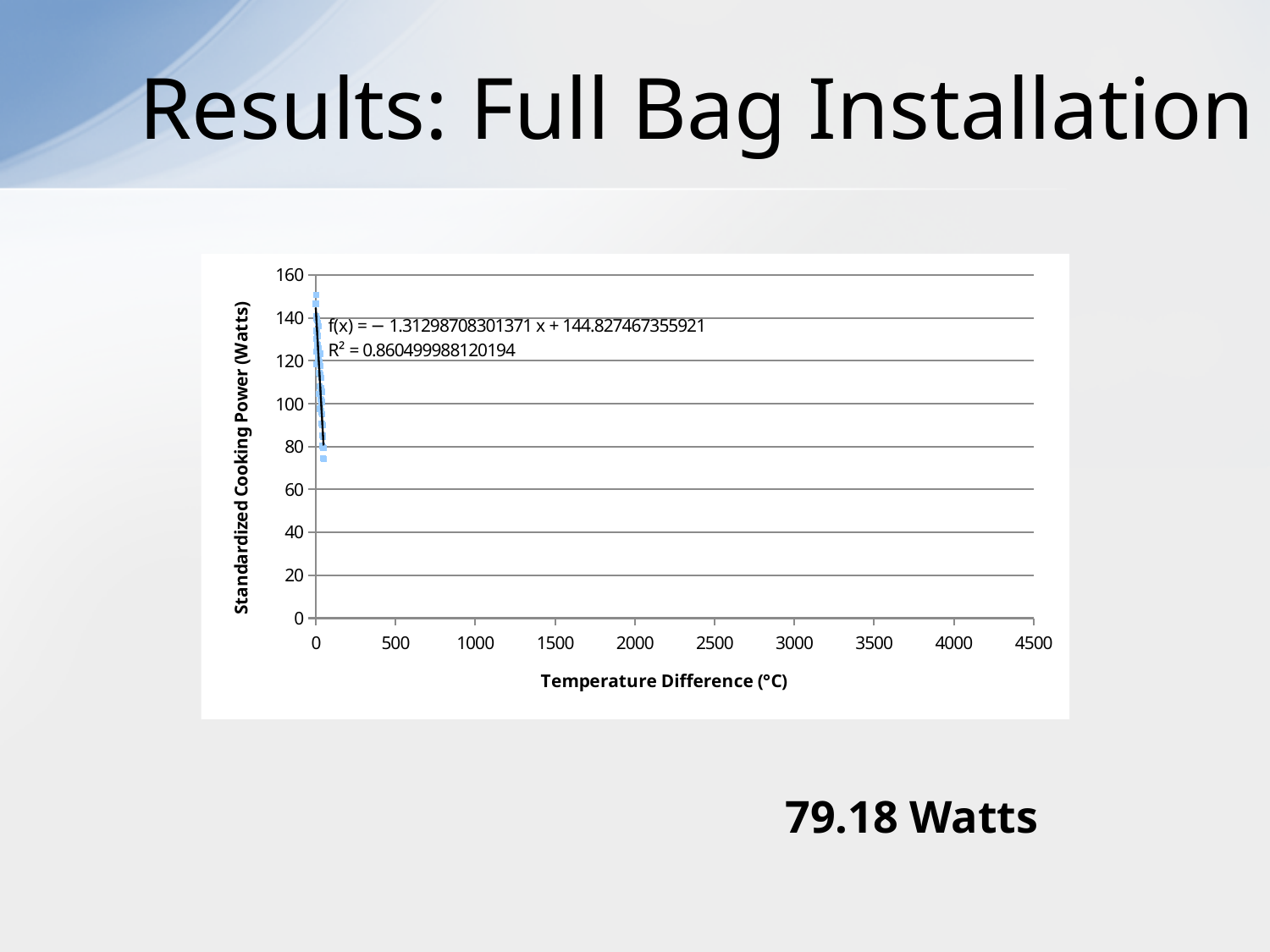
What is the trendline equation printed on the chart? f(x) = − 1.31298708301371 x + 144.827467355921 What is the title of the horizontal axis of the chart? Temperature Difference (°C) What is the maximum value shown on the horizontal axis of the chart? 4500 Is the lowest plotted cooking power value greater or less than 100? less Do the plotted values rise or fall as the temperature difference increases along the x axis? Fall What is the title of the vertical axis of the chart? Standardized Cooking Power (Watts) Is the highest plotted cooking power value greater or less than 140? greater What is the intercept of the trendline shown on the chart? 144.827467355921 What is the slope of the trendline shown on the chart? −1.31298708301371 What is the R² value printed on the chart? 0.860499988120194 Are the plotted temperature difference values greater or less than 500? less What kind of chart is shown on the slide? Scatter chart